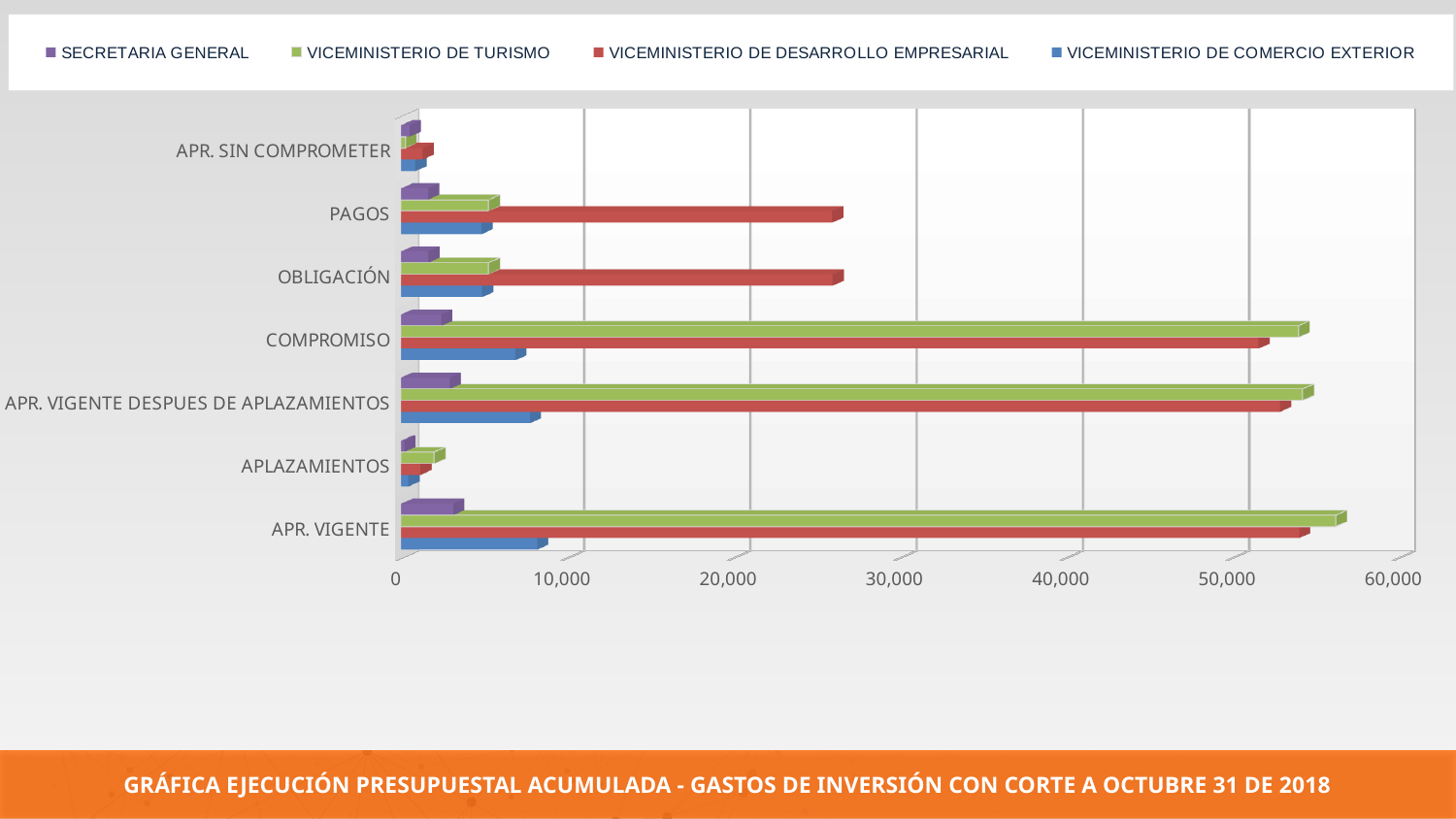
Is the value for VICEMINISTERIO DE COMERCIO EXTERIOR in APR. VIGENTE greater or less than 10,000? less In APR. VIGENTE, which is larger: the value for VICEMINISTERIO DE TURISMO or for SECRETARIA GENERAL? VICEMINISTERIO DE TURISMO In the PAGOS category, which series has the highest value? VICEMINISTERIO DE DESARROLLO EMPRESARIAL Is the value for VICEMINISTERIO DE DESARROLLO EMPRESARIAL in PAGOS greater or less than 20,000? greater Is the value for VICEMINISTERIO DE TURISMO in APLAZAMIENTOS greater or less than 10,000? less What is the title shown at the bottom of the slide for the chart? GRÁFICA EJECUCIÓN PRESUPUESTAL ACUMULADA - GASTOS DE INVERSIÓN CON CORTE A OCTUBRE 31 DE 2018 How many series does the legend list? 4 For VICEMINISTERIO DE TURISMO, which category has the lowest value? APR. SIN COMPROMETER In OBLIGACIÓN, which is larger: the value for VICEMINISTERIO DE DESARROLLO EMPRESARIAL or for VICEMINISTERIO DE TURISMO? VICEMINISTERIO DE DESARROLLO EMPRESARIAL How many categories are shown on the vertical axis of the chart? 7 What kind of chart is shown on the slide? Bar chart